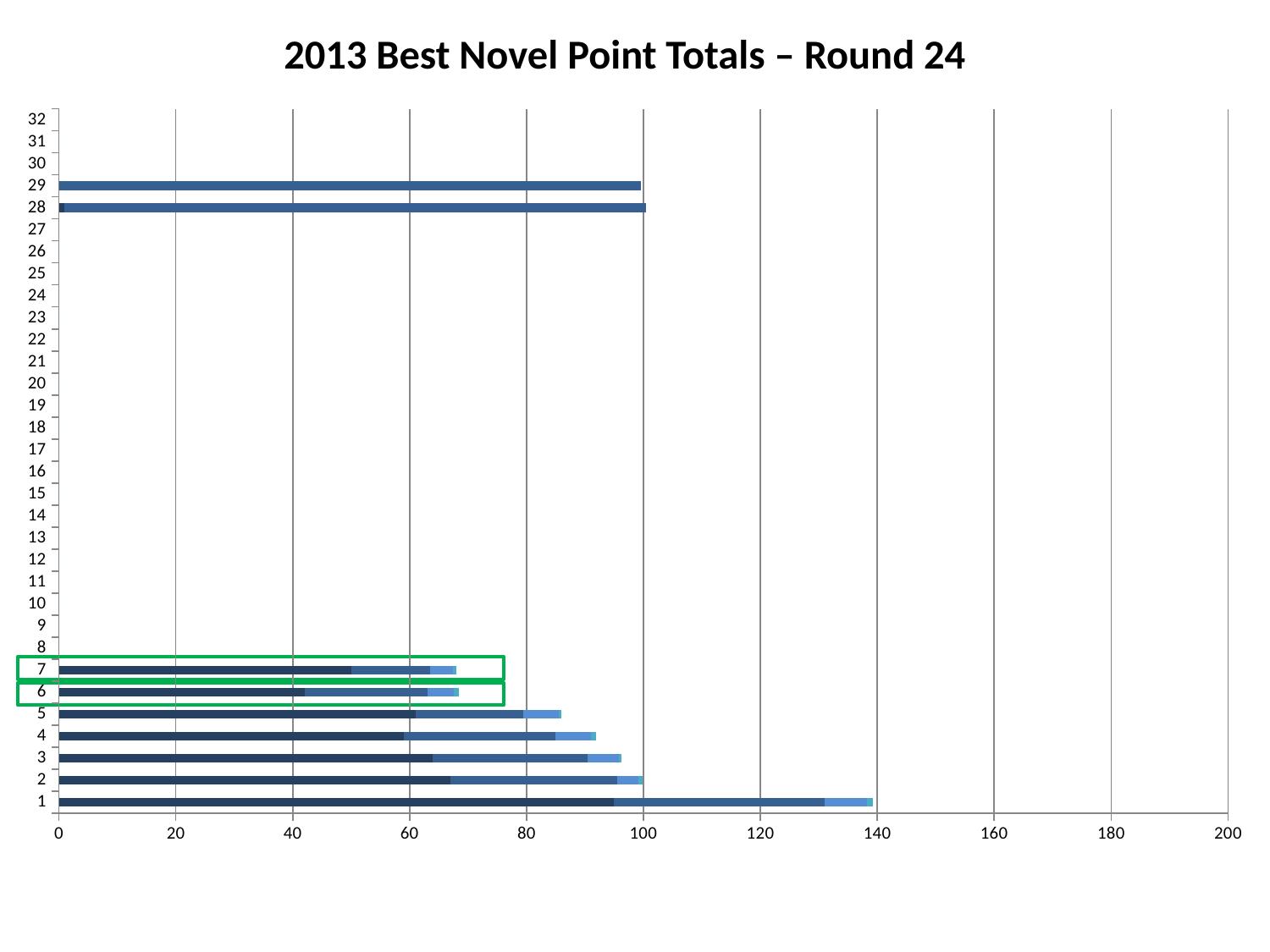
Which two categories are highlighted with green boxes on the chart? 6 and 7 Is the total value for category 7 greater or less than 80? less Is the total value for category 5 greater or less than 80? greater Which has a larger total, category 1 or category 2? 1 Is the total value for category 3 greater or less than 100? less How many categories are listed on the vertical axis of the chart? 32 What is the title of the chart? 2013 Best Novel Point Totals – Round 24 Which category has the longest bar in the chart? 1 What kind of chart is shown on the slide? bar chart Which has a larger total, category 5 or category 7? 5